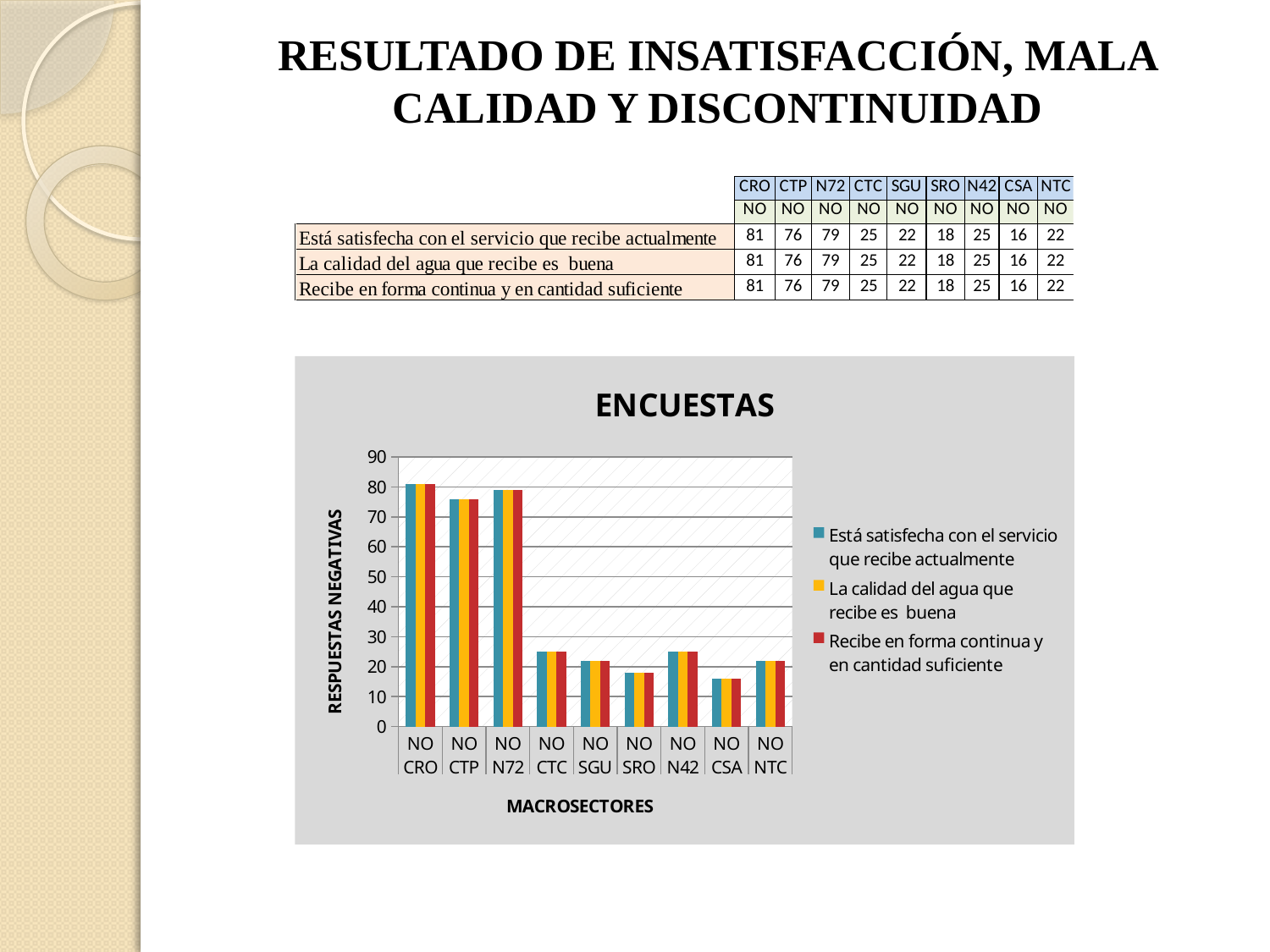
What is the value for CRO in the series 'Está satisfecha con el servicio que recibe actualmente'? 81 What is the difference between the values for CRO and CTP in the series 'Recibe en forma continua y en cantidad suficiente'? 5 Which macrosector has the highest value in the chart? CRO Which is larger, the value for CTC or the value for SGU? CTC How many macrosectores (categories) are shown on the x axis of the chart? 9 What type of chart is shown on the slide? bar chart What is the value for CSA in the series 'La calidad del agua que recibe es buena'? 16 What is the title of the chart? ENCUESTAS How many series does the chart legend list? 3 Is the value for N72 greater or less than 70? greater Which macrosector has the lowest value in the chart? CSA What is the label of the y axis of the chart? RESPUESTAS NEGATIVAS